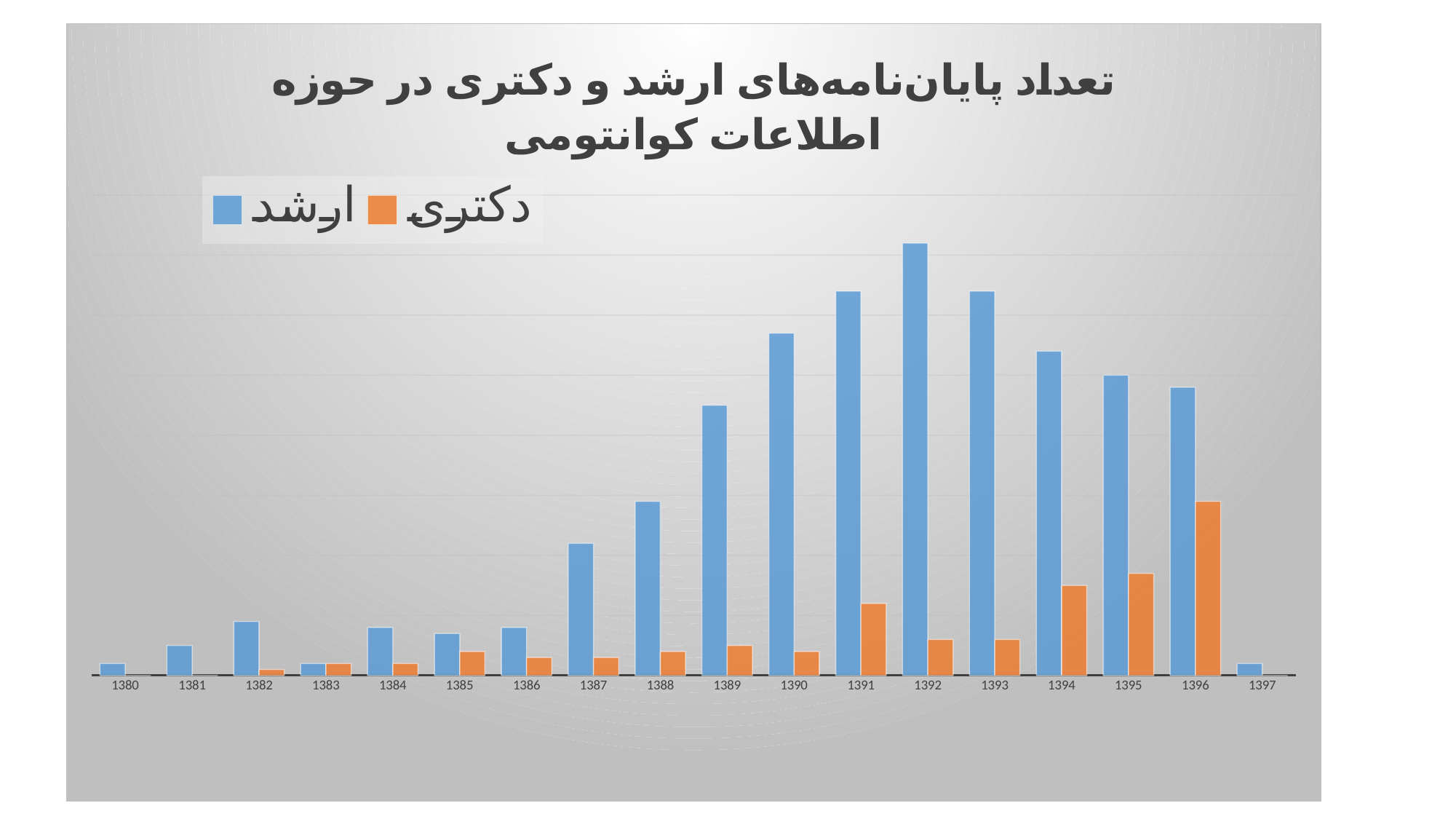
How many series does the legend list? 2 Do the values for ارشد rise or fall from 1386 to 1392? rise How many years (categories) are shown on the x axis? 18 Which is larger for ارشد: the value in 1387 or in 1388? 1388 In which year is the value for دکتری highest? 1396 Do the values for ارشد rise or fall from 1392 to 1397? fall Which colour represents the دکتری series? orange In which year is the value for ارشد highest? 1392 What kind of chart is shown on the slide? bar chart Which is larger for ارشد: the value in 1389 or in 1390? 1390 Which is larger for دکتری: the value in 1391 or in 1392? 1391